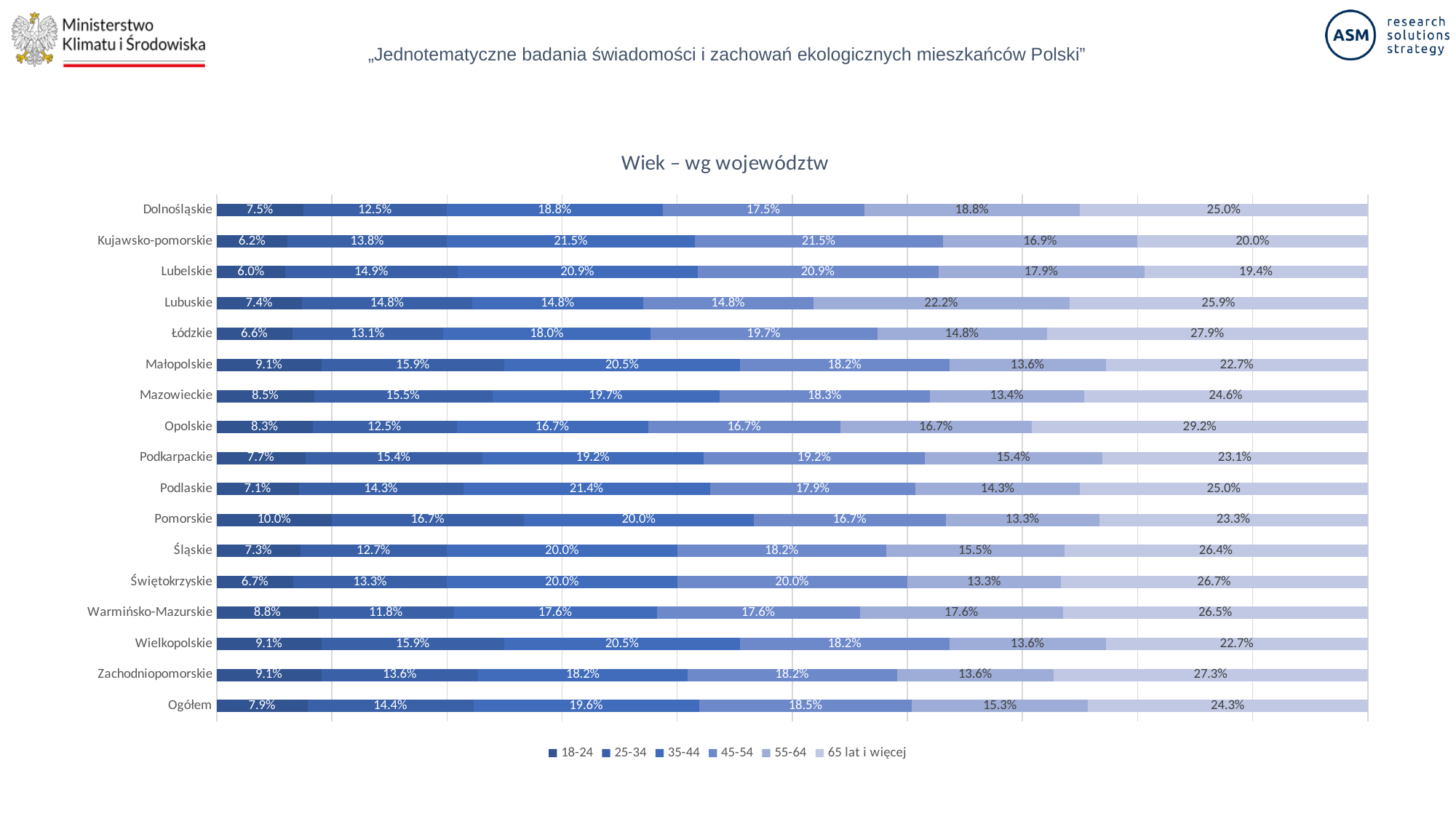
Which voivodeship has the highest value for the '65 lat i więcej' series? Opolskie How many categories (rows) are shown on the chart? 17 Which voivodeship has the highest value for the 18-24 series? Pomorskie How many series does the legend list? 6 What is the value for the '65 lat i więcej' series for Opolskie? 29.2% Which has a larger '65 lat i więcej' value, Łódzkie or Śląskie? Łódzkie Which voivodeship has the lowest value for the 18-24 series? Lubelskie What is the value for the 18-24 series for Dolnośląskie? 7.5% What is the value for the 35-44 series for Ogółem? 19.6% What is the total of the stacked bar for Ogółem? 100.0% What is the difference between the '65 lat i więcej' value and the 18-24 value for Dolnośląskie? 17.5 percentage points What kind of chart is shown on the slide? Stacked bar chart